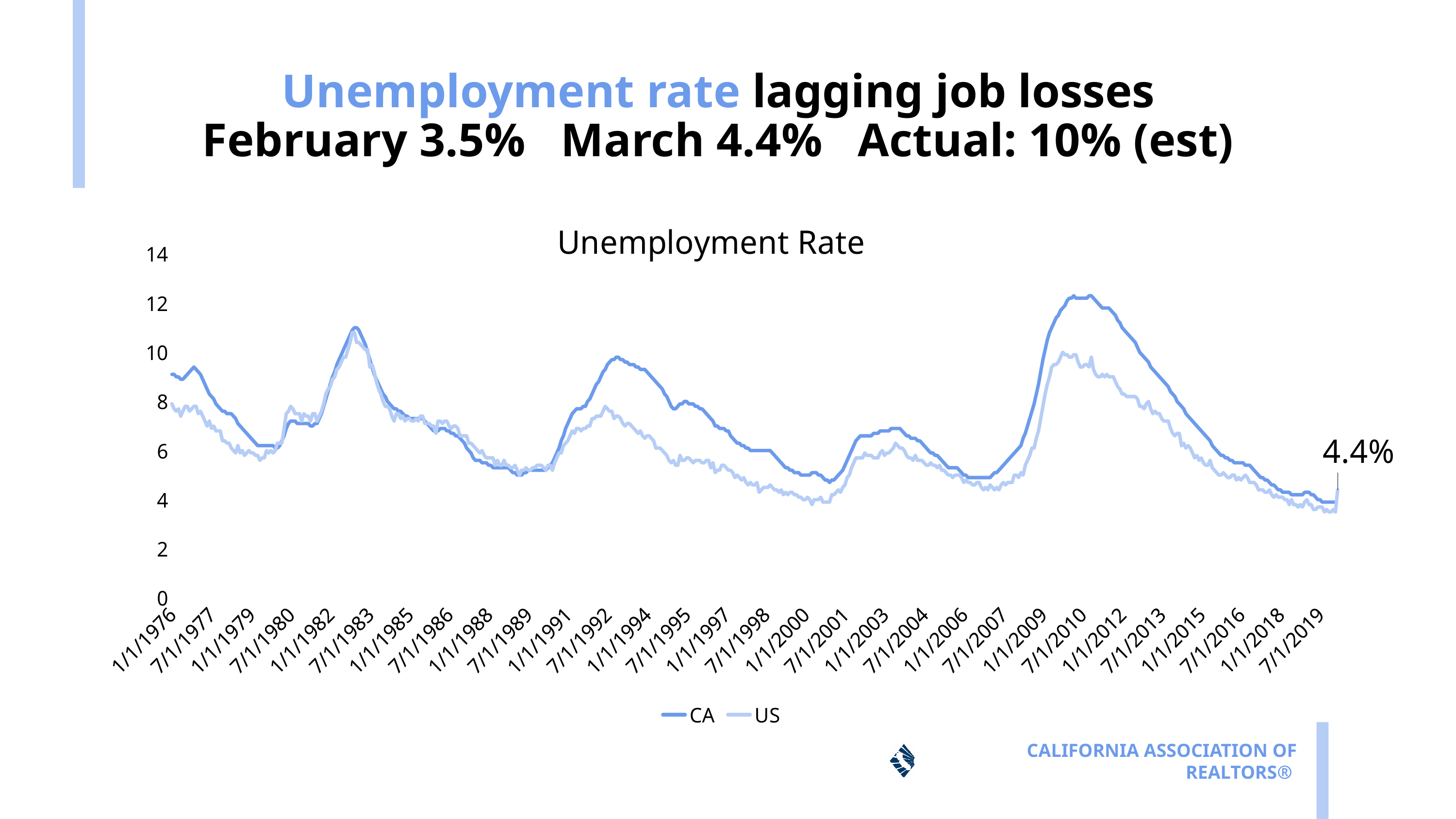
Does the CA line rise or fall between 7/1/2010 and 7/1/2019? fall How many series does the legend of the Unemployment Rate chart list? 2 Is the CA unemployment rate around 7/1/2010 greater or less than 10? greater Is the US unemployment rate around 1/1/2000 greater or less than 6? less What are the two series named in the legend of the chart? CA and US Around 7/1/2010, which series is higher, CA or US? CA What is the title of the chart? Unemployment Rate Around 7/1/1992, which series is higher, CA or US? CA Is the US unemployment rate around 7/1/2010 greater or less than 12? less What kind of chart is shown on the slide? line chart What is the highest value shown on the vertical axis of the chart? 14